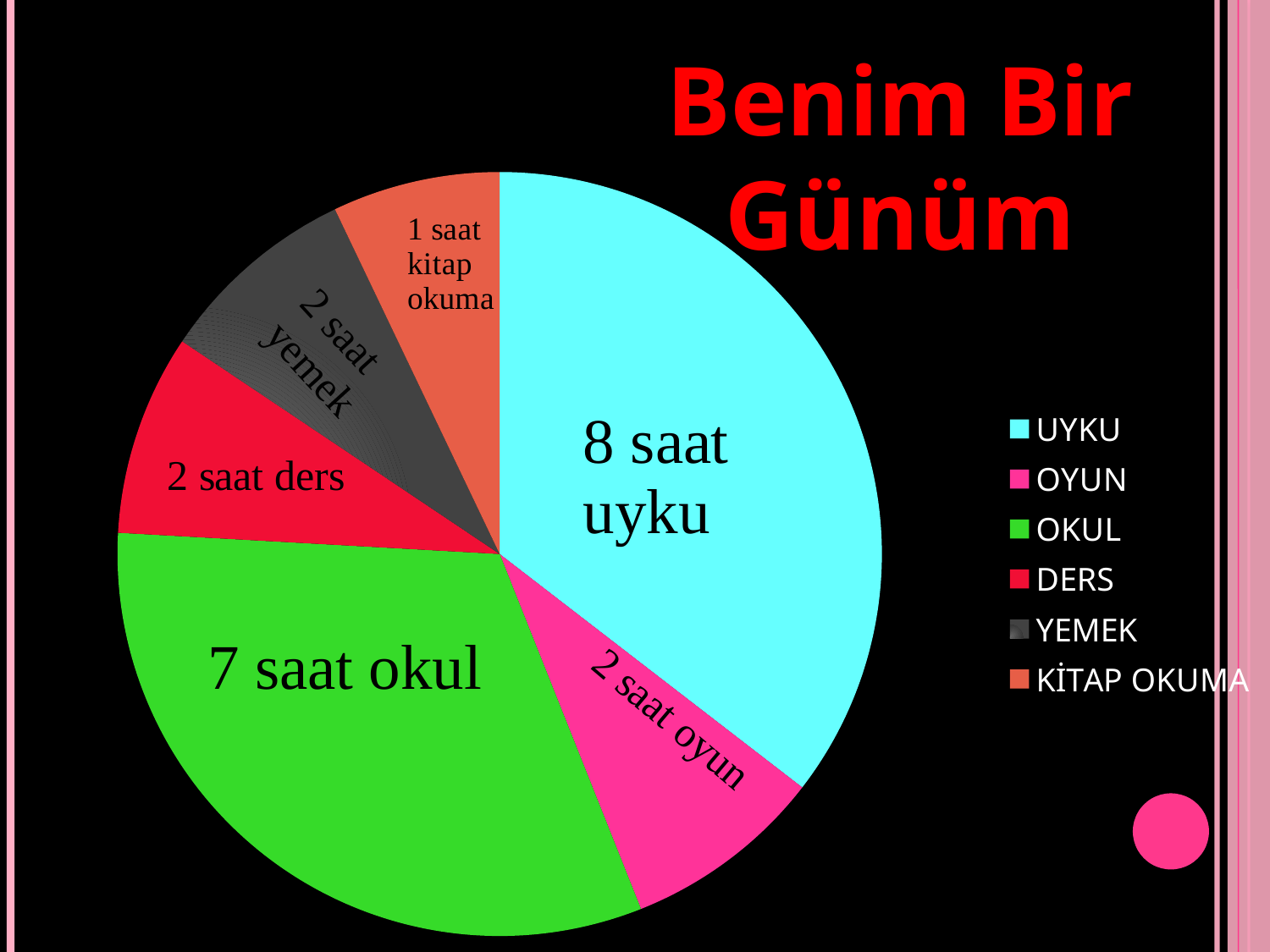
How many slices does the pie chart have? 6 What type of chart is shown on the slide? pie chart How many hours does the pie chart show for uyku (sleep)? 8 saat How many entries does the legend list? 6 How many hours does the pie chart show for kitap okuma (reading)? 1 saat How many hours does the pie chart show for okul (school)? 7 saat Which is larger in the pie chart, the slice for oyun or the slice for okul? okul How many more hours are spent on uyku than on okul according to the chart? 1 saat Which activity has the largest slice in the pie chart? uyku What is the title of the slide containing the pie chart? Benim Bir Günüm How many hours does the pie chart show for oyun (play)? 2 saat Which activity has the smallest slice in the pie chart? kitap okuma